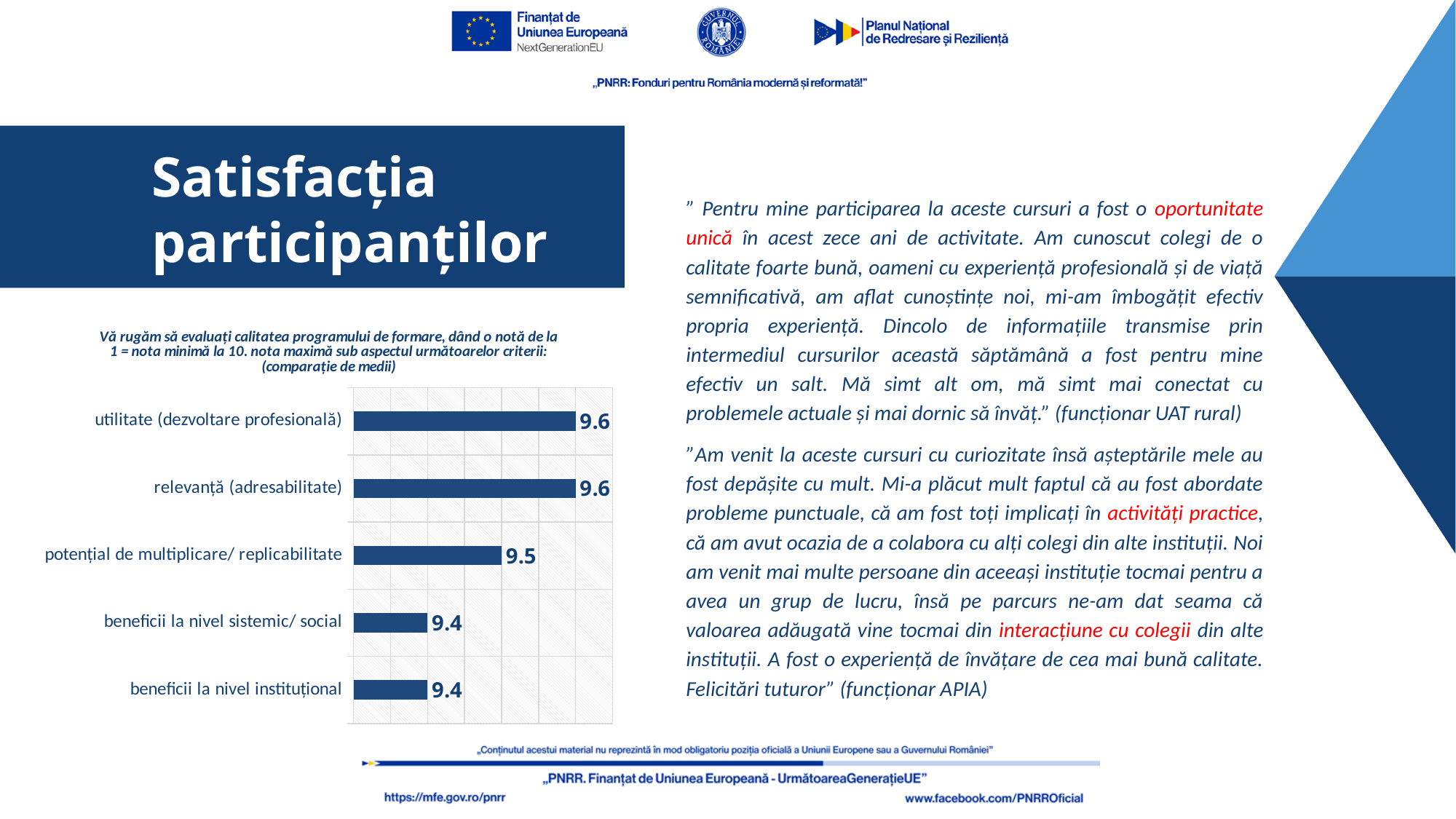
What is the value for "utilitate (dezvoltare profesională)"? 9.6 What is the value for "beneficii la nivel sistemic/ social"? 9.4 How many categories are shown in the chart? 5 Which is larger, the value for "potențial de multiplicare/ replicabilitate" or the value for "beneficii la nivel instituțional"? potențial de multiplicare/ replicabilitate What is the value for "beneficii la nivel instituțional"? 9.4 Which is larger, the value for "relevanță (adresabilitate)" or the value for "potențial de multiplicare/ replicabilitate"? relevanță (adresabilitate) What kind of chart is shown on the slide? bar chart What is the value for "potențial de multiplicare/ replicabilitate"? 9.5 What is the difference between the values for "utilitate (dezvoltare profesională)" and "beneficii la nivel instituțional"? 0.2 What is the difference between the values for "potențial de multiplicare/ replicabilitate" and "beneficii la nivel sistemic/ social"? 0.1 What is the value for "relevanță (adresabilitate)"? 9.6 What colour are the bars in the chart? dark blue